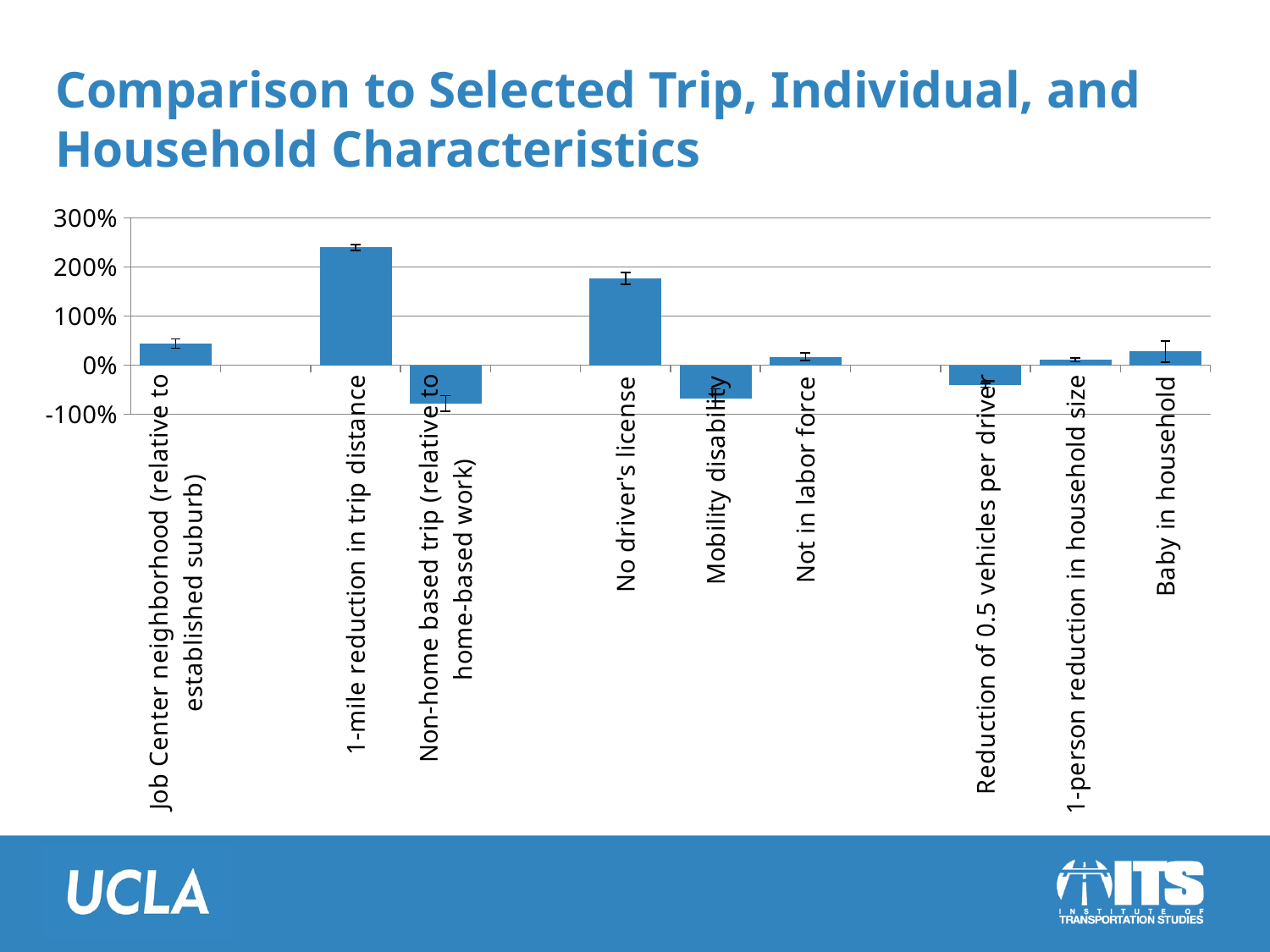
Which category has the highest value in the chart? 1-mile reduction in trip distance Is the value for Mobility disability greater or less than 0%? less Which is larger, the value for Job Center neighborhood (relative to established suburb) or the value for Not in labor force? Job Center neighborhood (relative to established suburb) Is the value for 1-mile reduction in trip distance greater or less than 200%? greater What is the title of the slide containing the chart? Comparison to Selected Trip, Individual, and Household Characteristics Is the value for Job Center neighborhood (relative to established suburb) greater or less than 100%? less What kind of chart is shown on the slide? bar chart Which category has the lowest value in the chart? Non-home based trip (relative to home-based work) Which is larger, the value for 1-mile reduction in trip distance or the value for No driver's license? 1-mile reduction in trip distance How many categories are plotted in the chart? 9